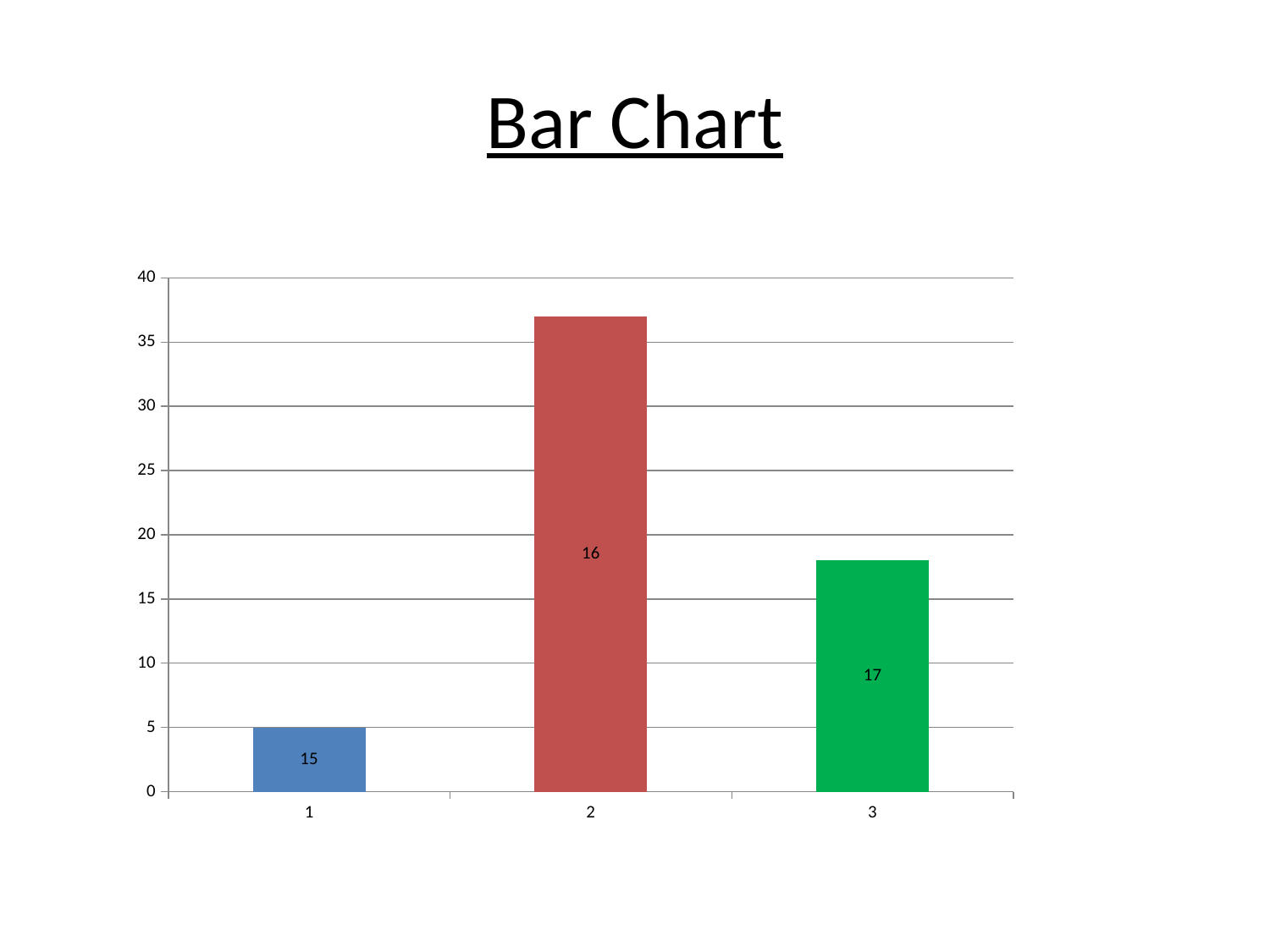
What is the title of the chart? Bar Chart Is the value for category 3 greater or less than 20? less Is the value for category 2 greater or less than 35? greater How many bars are plotted in the chart? 3 What kind of chart is shown on the slide? bar chart What value does the bar for category 1 reach on the vertical axis? 5 Which bar is taller, category 2 or category 3? 2 Which category has the tallest bar? 2 Which bar is taller, category 1 or category 3? 3 What colour is the bar for category 3? green Which category has the shortest bar? 1 Is the value for category 3 greater or less than 15? greater